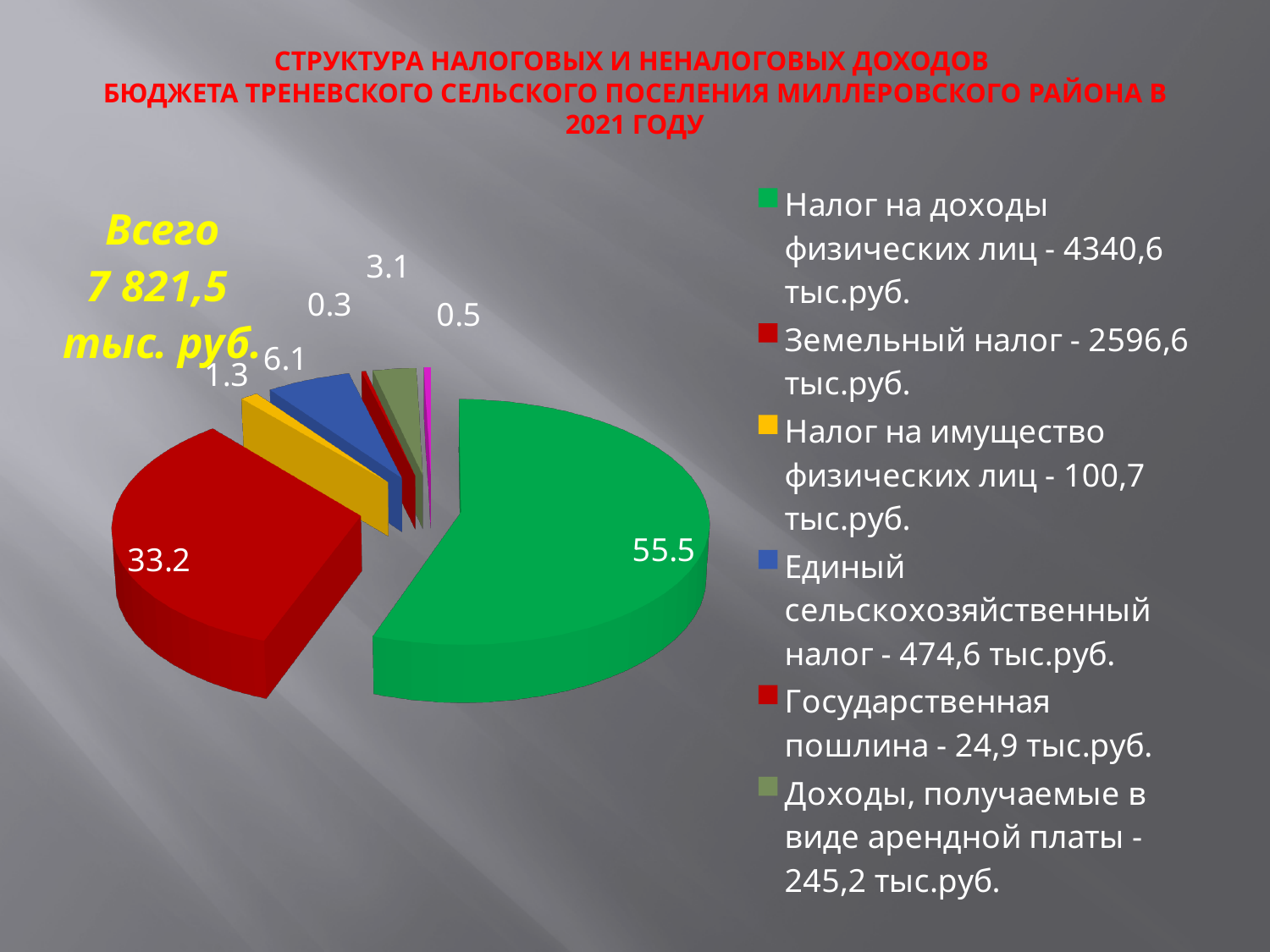
What value is labelled on the blue slice (Единый сельскохозяйственный налог)? 6.1 What value is labelled on the yellow slice (Налог на имущество физических лиц)? 1.3 Which slice is larger: the blue one (Единый сельскохозяйственный налог) or the yellow one (Налог на имущество физических лиц)? Единый сельскохозяйственный налог What type of chart is shown on the slide? pie chart According to the legend, how much is Земельный налог in thousand rubles? 2596,6 тыс.руб. Which year does the chart title refer to? 2021 What value is labelled on the red slice (Земельный налог)? 33.2 Which category has the largest slice of the pie? Налог на доходы физических лиц What percentage of the pie is labelled for the green slice (Налог на доходы физических лиц)? 55.5 What is the difference between the labelled values of the green slice (55.5) and the red slice (33.2)? 22.3 How many entries does the legend list? 6 What total amount is stated on the slide next to the pie chart? 7 821,5 тыс. руб.